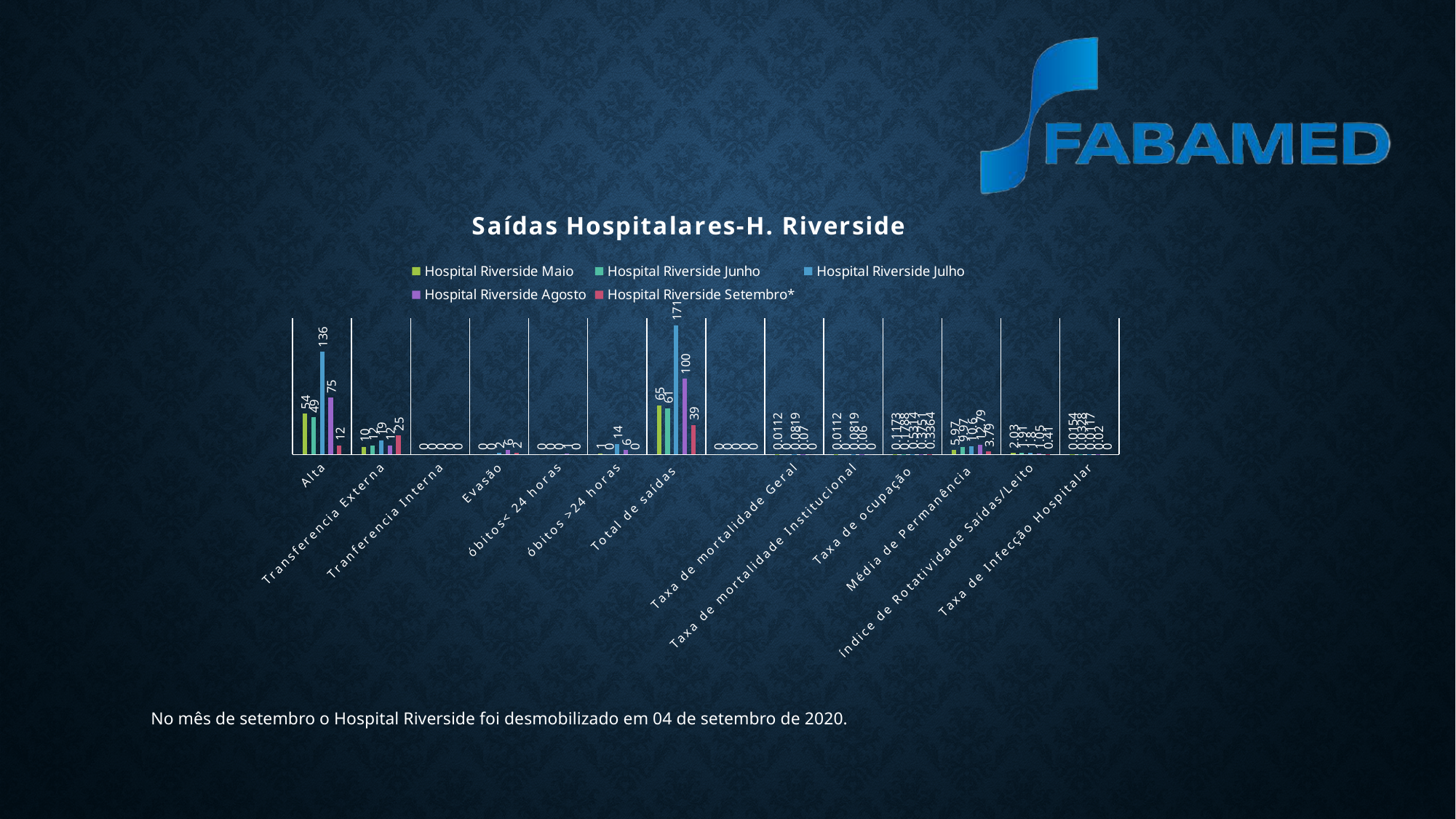
What is the value for Hospital Riverside Agosto in the Total de saídas category? 100 What is the value for Hospital Riverside Setembro* in the Total de saídas category? 39 What kind of chart is shown on the slide? Bar chart How many series does the legend list? 5 Which series has the highest value in the Total de saídas category? Hospital Riverside Julho What is the title of the chart? Saídas Hospitalares-H. Riverside Which series has the lowest value in the Alta category? Hospital Riverside Setembro* In the Total de saídas category, which is larger: Hospital Riverside Maio or Hospital Riverside Junho? Hospital Riverside Maio How many categories are shown on the x axis of the chart? 13 What is the difference between the Hospital Riverside Julho and Hospital Riverside Agosto values in the Alta category? 61 What is the value for Hospital Riverside Maio in the Alta category? 54 What is the value for Hospital Riverside Julho in the Alta category? 136